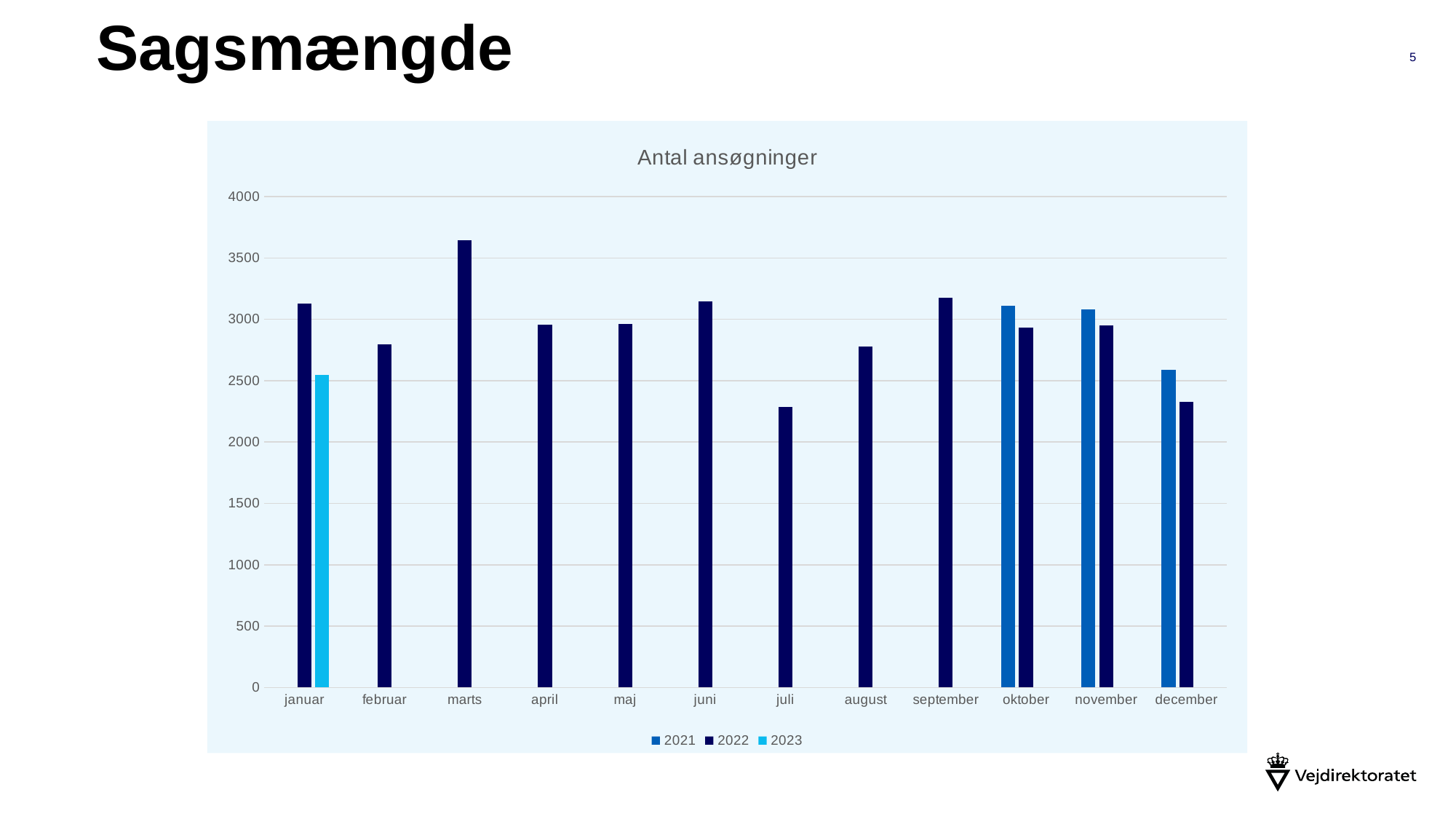
Is the 2021 value for oktober greater or less than 3000? greater Is the 2022 value for juli greater or less than 2500? less What is the title of the chart? Antal ansøgninger How many months are shown on the x axis? 12 In december, which series has the larger value, 2021 or 2022? 2021 Which month has the highest value for 2022? marts In januar, which series has the larger value, 2022 or 2023? 2022 For which months are 2021 values plotted? oktober, november, december Is the 2022 value for marts greater or less than 3500? greater How many series does the legend list? 3 What kind of chart is shown on the slide? bar chart